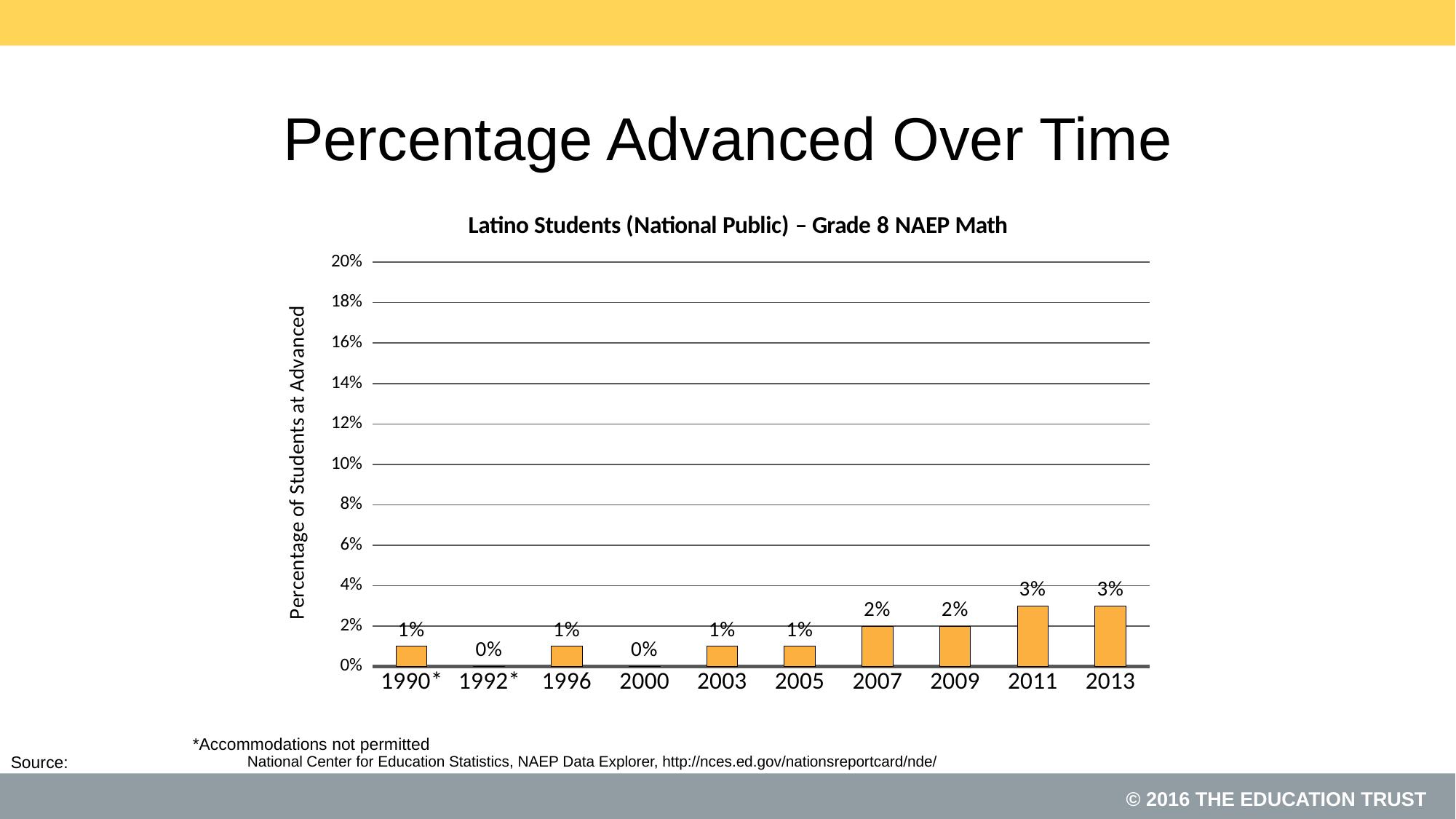
Do the values generally rise or fall from 2003 to 2013? rise What is the value for 2013? 3% Which is larger, the value for 2009 or the value for 2005? 2009 Is the value for 2011 greater or less than 2%? greater What kind of chart is this? bar chart How many years are shown on the x axis? 10 What is the value for 2003? 1% What is the title of the chart? Latino Students (National Public) – Grade 8 NAEP Math What is the value for 1992*? 0% What is the difference between the values for 2013 and 1996? 2% What is the label on the y axis? Percentage of Students at Advanced What is the value for 2007? 2%